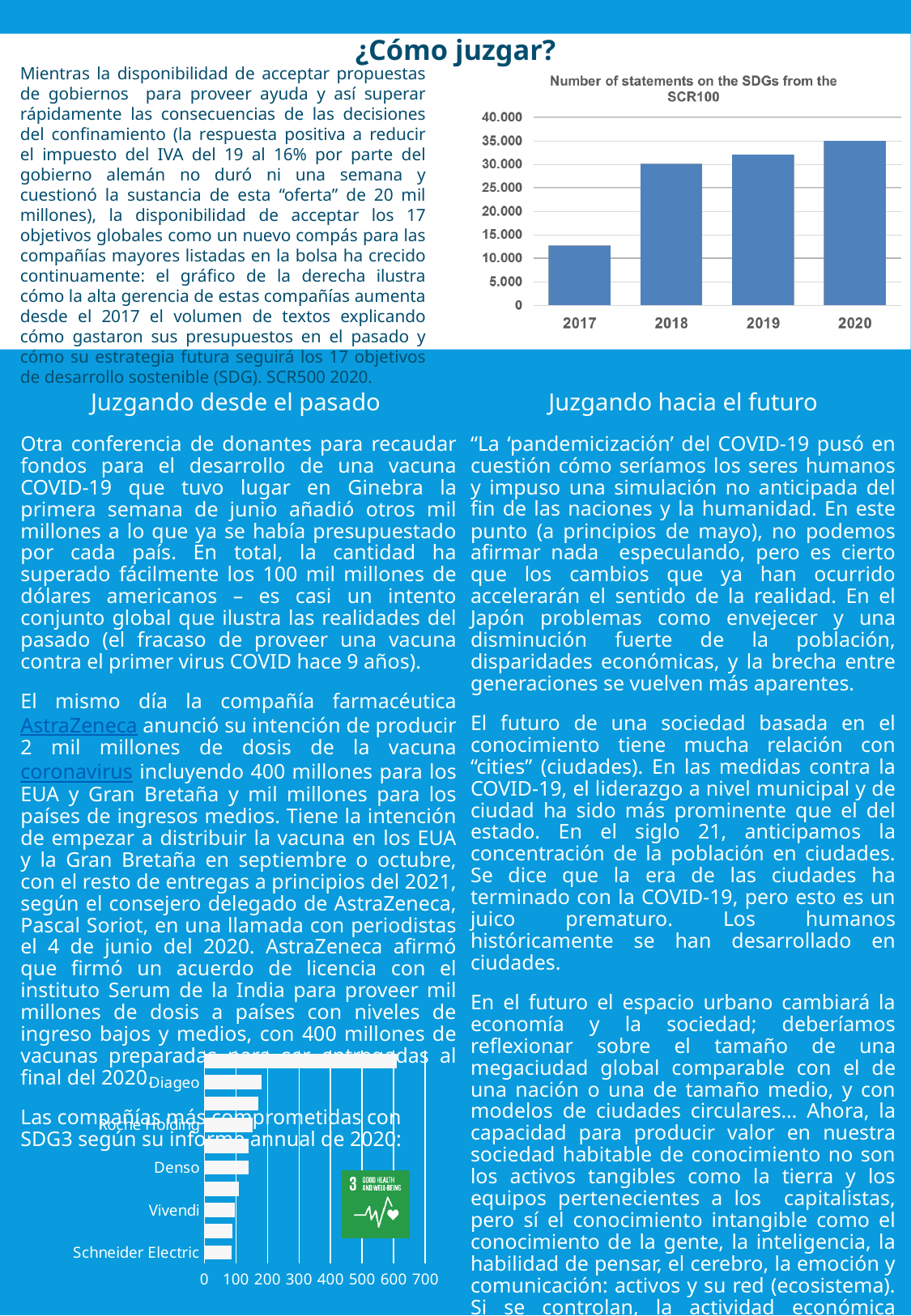
In the chart 'Number of statements on the SDGs from the SCR100', is the value for 2018 greater or less than 25.000? greater In the bottom-left chart of companies, which has the larger value, Diageo or Schneider Electric? Diageo In the chart 'Number of statements on the SDGs from the SCR100', is the value for 2020 greater or less than 30.000? greater In the chart 'Number of statements on the SDGs from the SCR100', which year has the lowest value? 2017 In the chart 'Number of statements on the SDGs from the SCR100', how many years are shown on the x axis? 4 In the bottom-left chart of companies, is the value for Diageo greater or less than 300? less In the chart 'Number of statements on the SDGs from the SCR100', do the values rise or fall from 2017 to 2020? rise What type of chart is the chart at the bottom left of the slide listing companies such as Diageo and Schneider Electric? bar chart In the chart 'Number of statements on the SDGs from the SCR100', which year has the highest value? 2020 What type of chart is the chart titled 'Number of statements on the SDGs from the SCR100'? bar chart In the chart 'Number of statements on the SDGs from the SCR100', which year has the larger value, 2017 or 2020? 2020